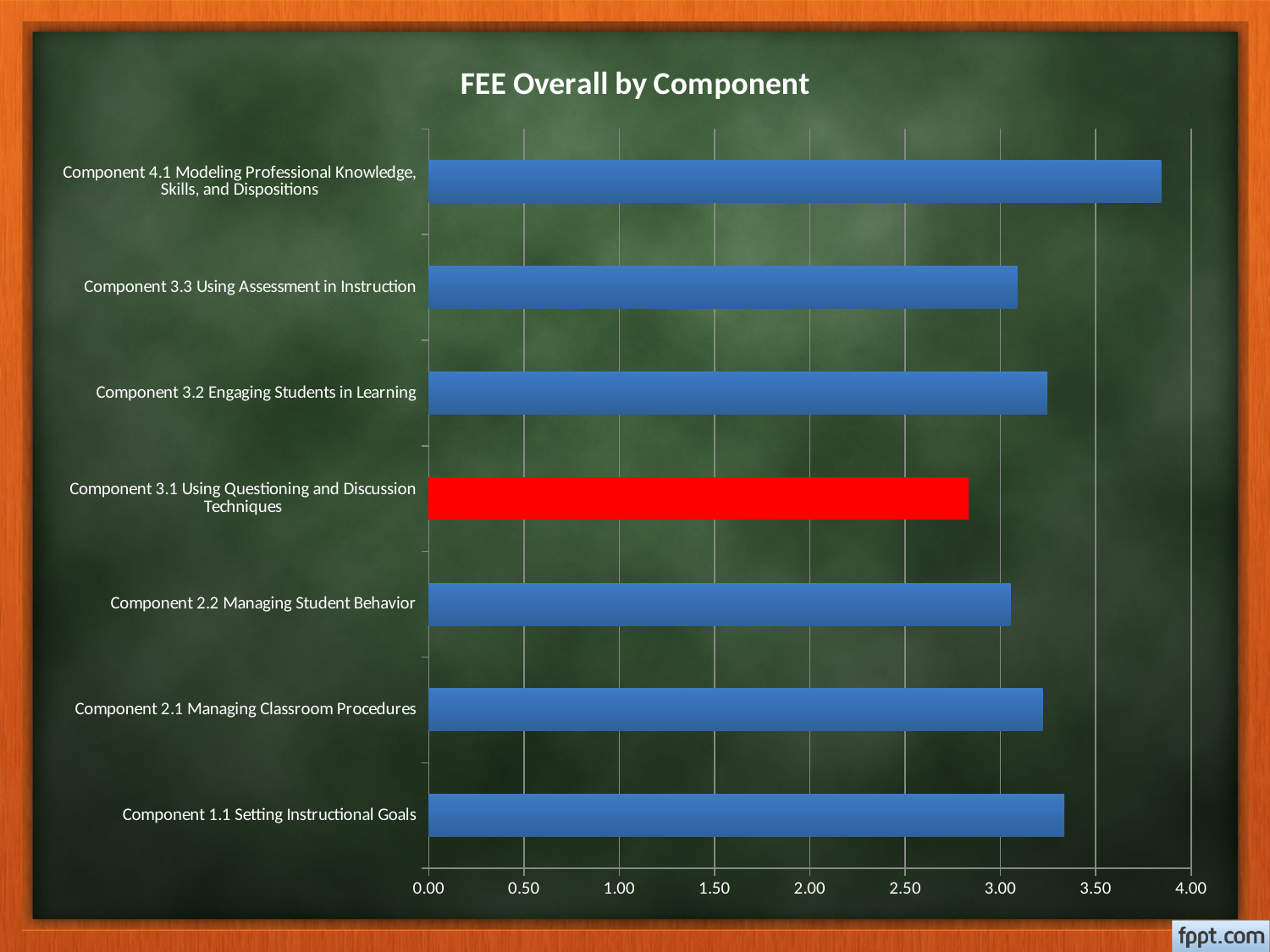
Is the value for Component 4.1 Modeling Professional Knowledge, Skills, and Dispositions greater or less than 3.50? greater Is the value for Component 1.1 Setting Instructional Goals greater or less than 3.50? less Is the value for Component 3.1 Using Questioning and Discussion Techniques greater or less than 3.00? less How many components are plotted in the chart? 7 What kind of chart is shown on the slide? bar chart Which component has the highest value? Component 4.1 Modeling Professional Knowledge, Skills, and Dispositions Which component's bar is coloured red rather than blue? Component 3.1 Using Questioning and Discussion Techniques Which has the larger value, Component 3.1 Using Questioning and Discussion Techniques or Component 2.1 Managing Classroom Procedures? Component 2.1 Managing Classroom Procedures What is the title of the chart? FEE Overall by Component Which has the larger value, Component 1.1 Setting Instructional Goals or Component 3.3 Using Assessment in Instruction? Component 1.1 Setting Instructional Goals Which component has the lowest value? Component 3.1 Using Questioning and Discussion Techniques